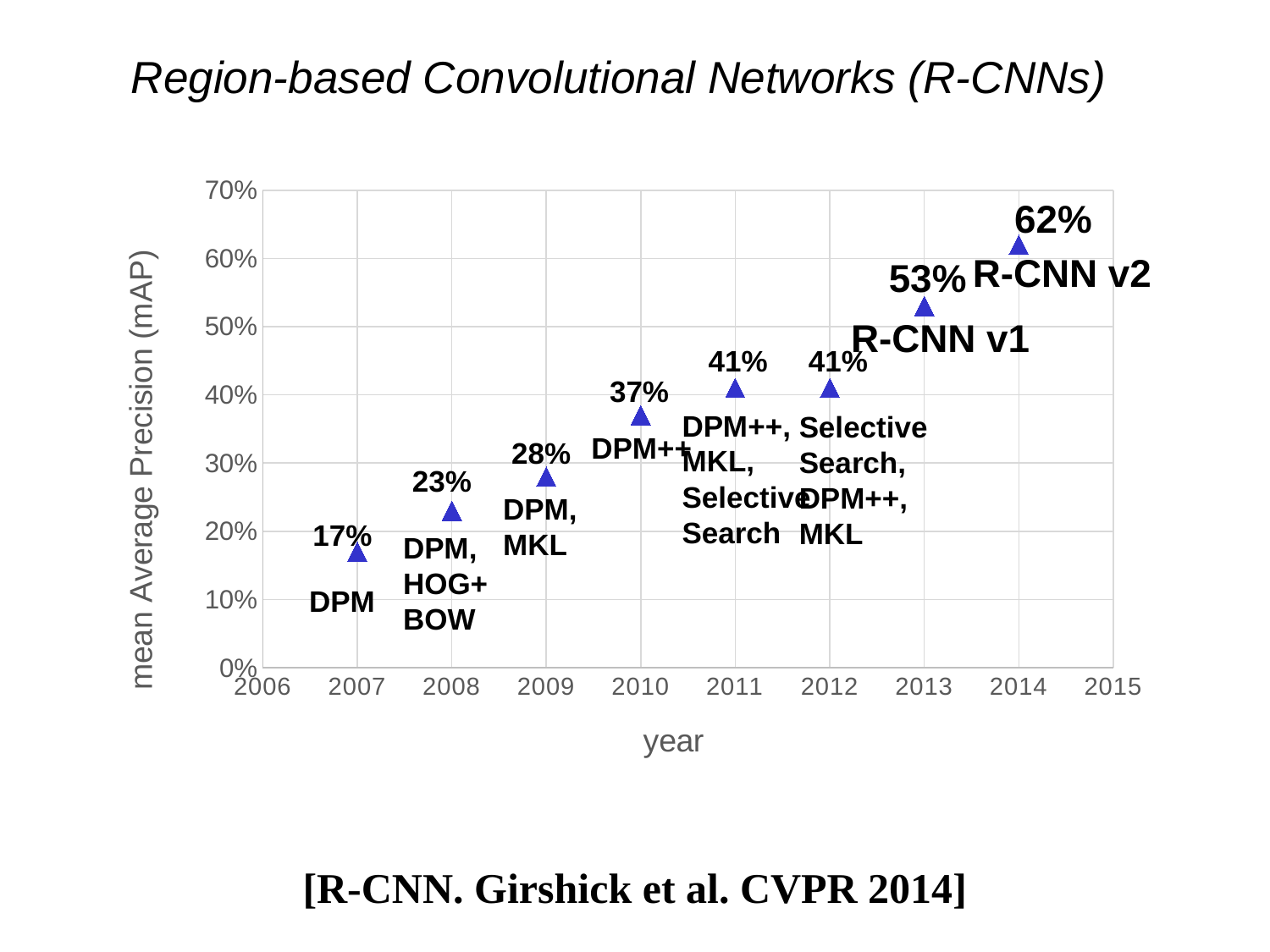
What is the mean Average Precision (mAP) plotted for 2007? 17% What is the difference in mAP between 2014 (62%) and 2013 (53%)? 9% What is the mAP value plotted for 2010? 37% Which year has the lowest mAP value on the chart? 2007 Do the mAP values generally rise or fall from 2007 to 2014? rise What is the mAP value plotted for 2014? 62% Which year has the highest mAP value on the chart? 2014 What is the label on the y axis of the chart? mean Average Precision (mAP) What is the difference in mAP between 2009 and 2008? 5% What mAP value is shown for 2013, labelled R-CNN v1? 53% Which has a higher mAP, 2010 or 2011? 2011 How many data points are plotted on the chart? 8